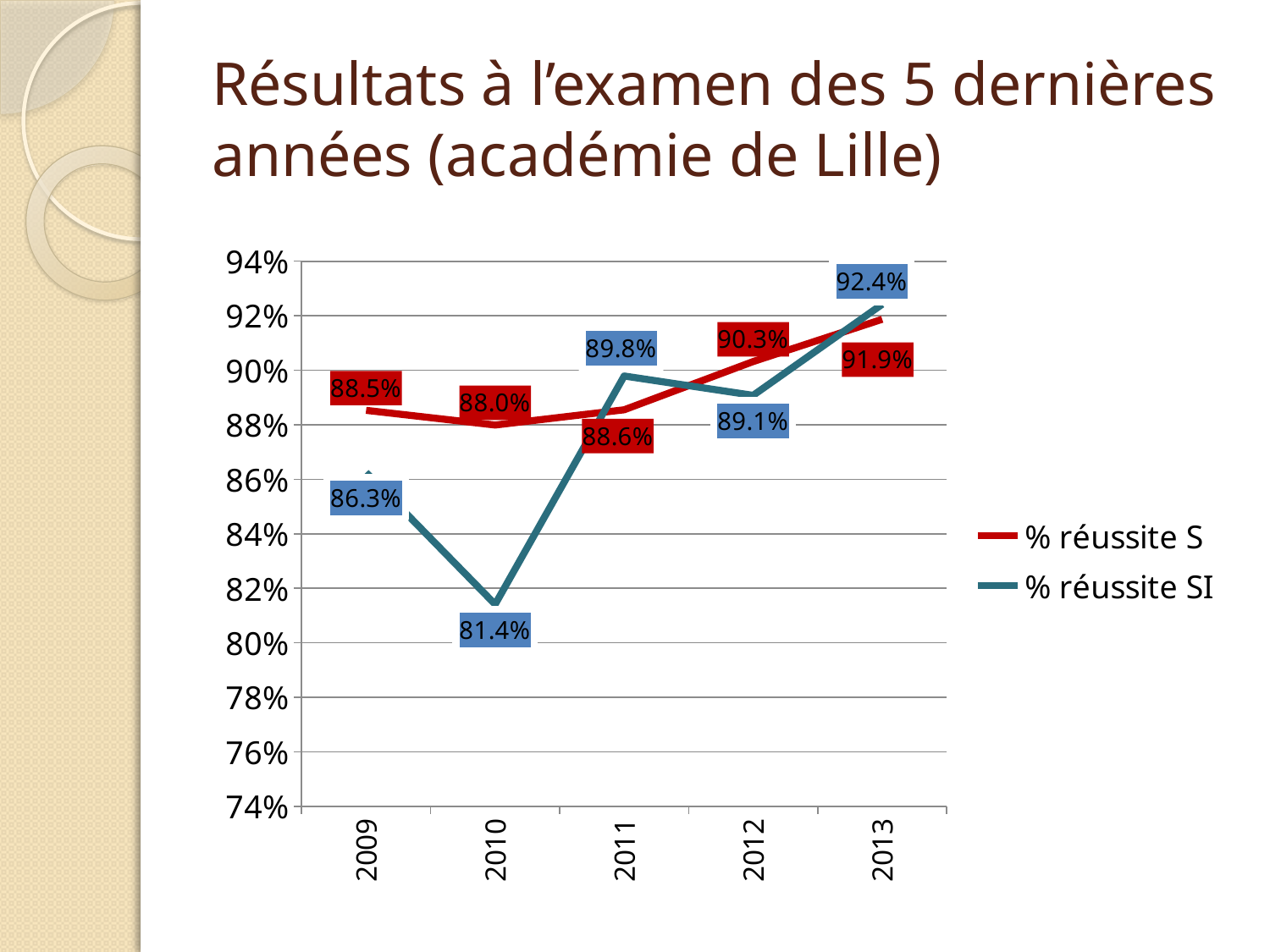
What type of chart is shown on the slide? line chart What is the value of % réussite SI in 2010? 81.4% In which year is % réussite S highest? 2013 How many series does the legend list? 2 What is the difference between % réussite S and % réussite SI in 2010? 6.6% Which series has the higher value in 2011, % réussite S or % réussite SI? % réussite SI Does % réussite S rise or fall between 2011 and 2013? rise How many years are shown on the x axis? 5 What is the value of % réussite S in 2012? 90.3% What is the value of % réussite SI in 2013? 92.4% What is the value of % réussite S in 2009? 88.5% In which year is % réussite SI lowest? 2010